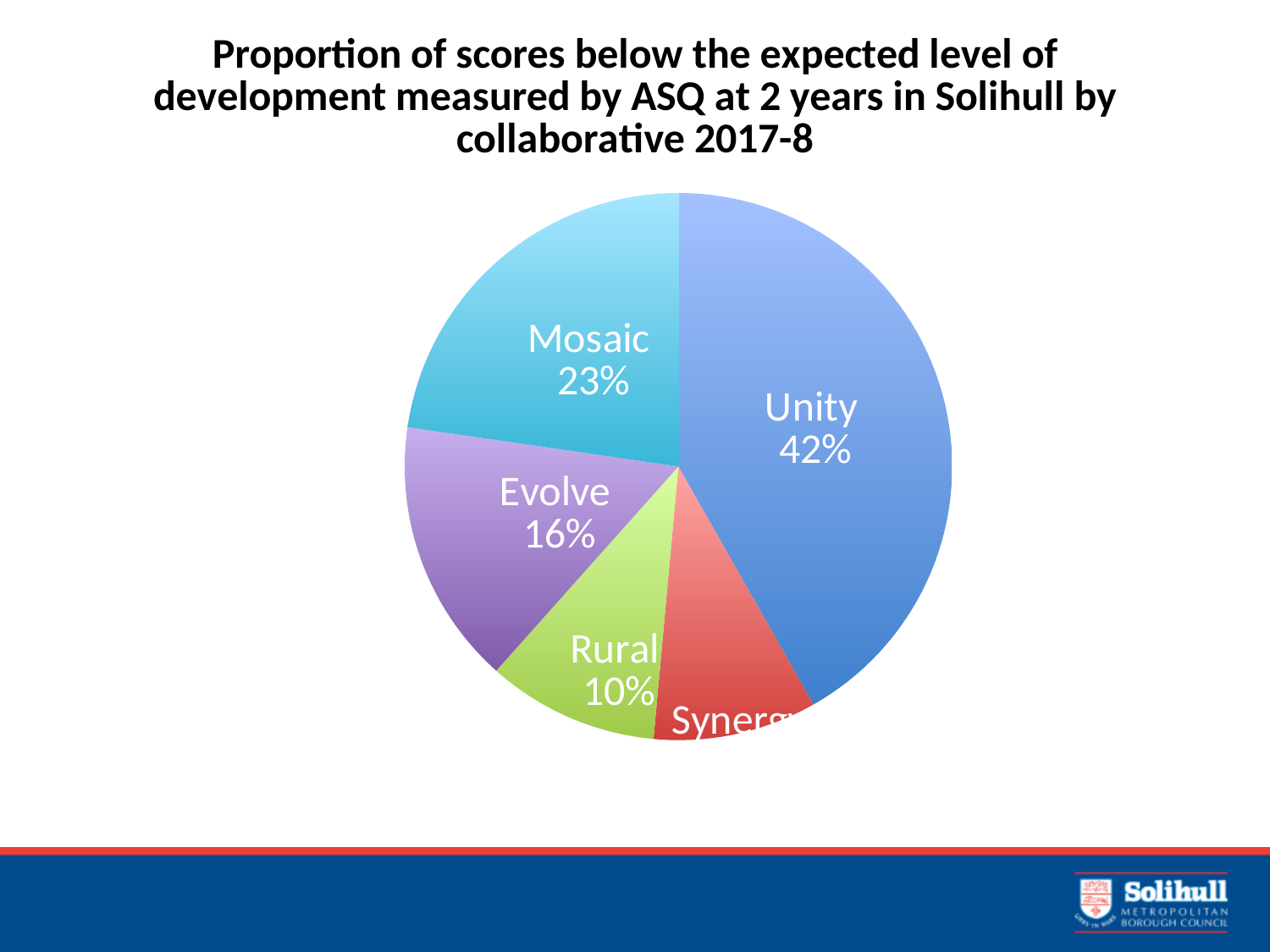
What is the value shown for Mosaic? 23% Which is larger, the slice for Mosaic or the slice for Evolve? Mosaic What kind of chart is shown on the slide? pie chart What share of the pie does Unity account for? 42% Which is larger, the slice for Unity or the slice for Rural? Unity What is the value shown for Rural? 10% What is the difference in percentage points between Evolve and Rural? 6% How many slices does the pie chart have? 5 Which collaborative has the largest slice of the pie? Unity What is the value shown for Evolve? 16% What is the difference in percentage points between Unity and Mosaic? 19% What is the title of the chart? Proportion of scores below the expected level of development measured by ASQ at 2 years in Solihull by collaborative 2017-8